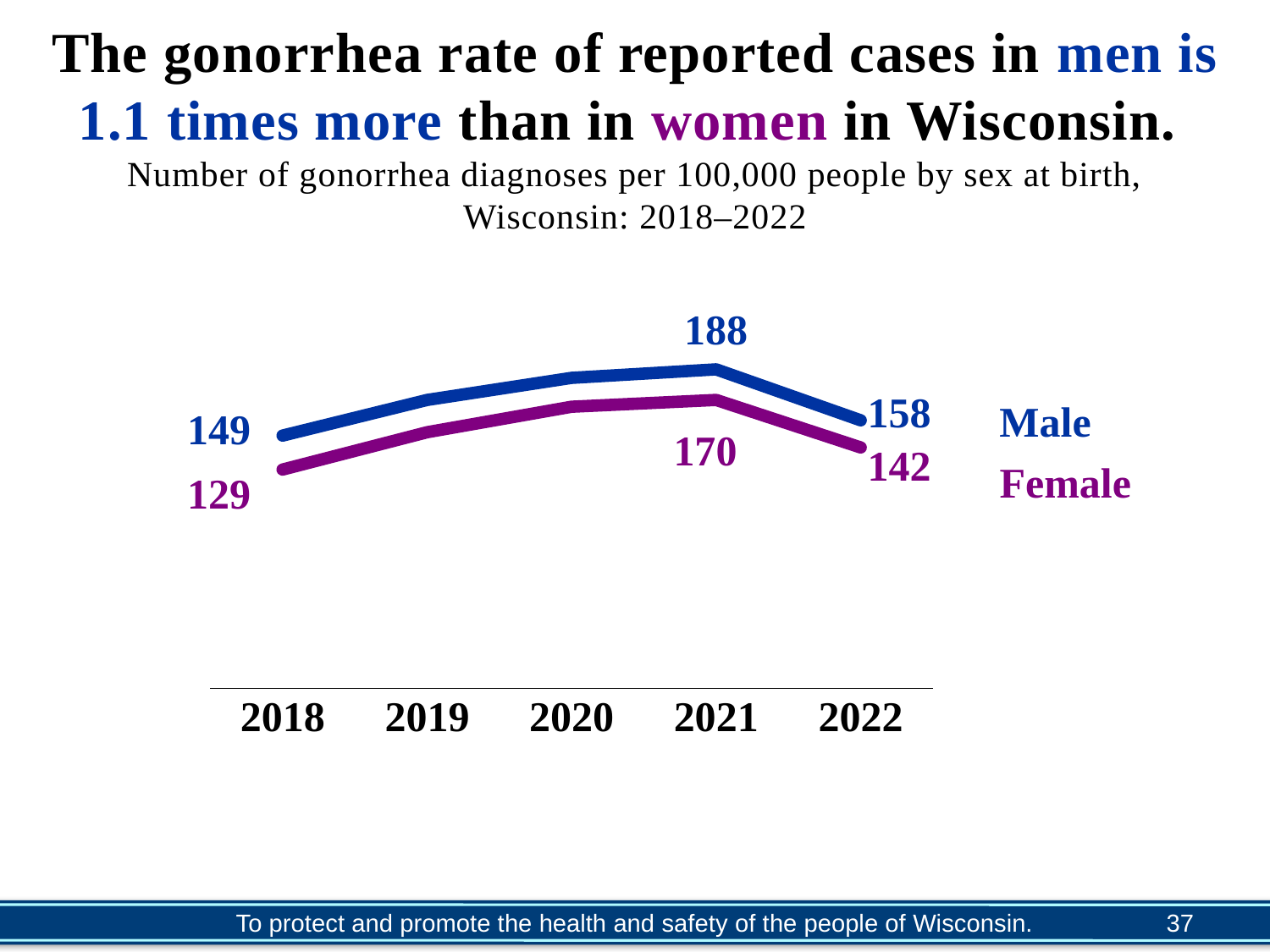
In which year was the Female rate lowest? 2018 What is the difference between the Male and Female rates in 2021? 18 What was the Male gonorrhea rate per 100,000 in 2022? 158 What is the difference between the Male rate in 2021 and the Male rate in 2022? 30 Which series had the higher rate in 2022, Male or Female? Male How many years are shown on the x axis? 5 How many series does the chart show? 2 What kind of chart is this? Line chart What was the Male gonorrhea rate per 100,000 in 2018? 149 What was the Female gonorrhea rate per 100,000 in 2021? 170 What was the Female gonorrhea rate per 100,000 in 2018? 129 In which year was the Male rate highest? 2021